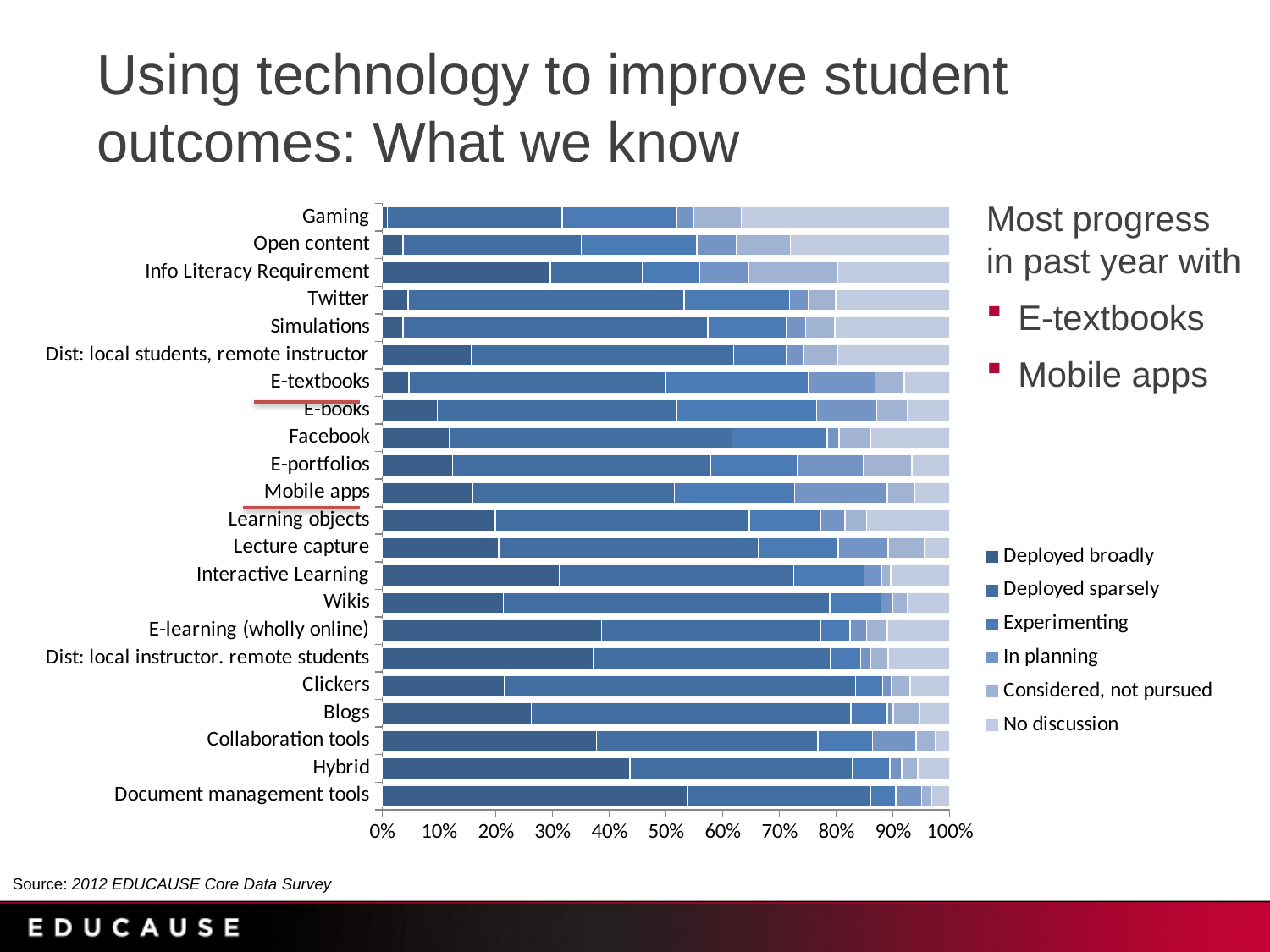
Which category has the largest 'Deployed broadly' segment? Document management tools Which has the larger 'Deployed broadly' segment, Hybrid or Blogs? Hybrid How many technology categories are listed on the chart's vertical axis? 22 Is the 'Deployed broadly' value for Gaming greater or less than 10%? less Is the 'Deployed broadly' value for Document management tools greater or less than 50%? greater Which category has the smallest 'Deployed broadly' segment? Gaming Is the 'Deployed broadly' value for Blogs greater or less than 30%? less What kind of chart is shown on the slide? Stacked bar chart According to the slide, which two technologies showed the most progress in the past year? E-textbooks and Mobile apps How many series does the chart's legend list? 6 What is the first series listed in the chart's legend? Deployed broadly